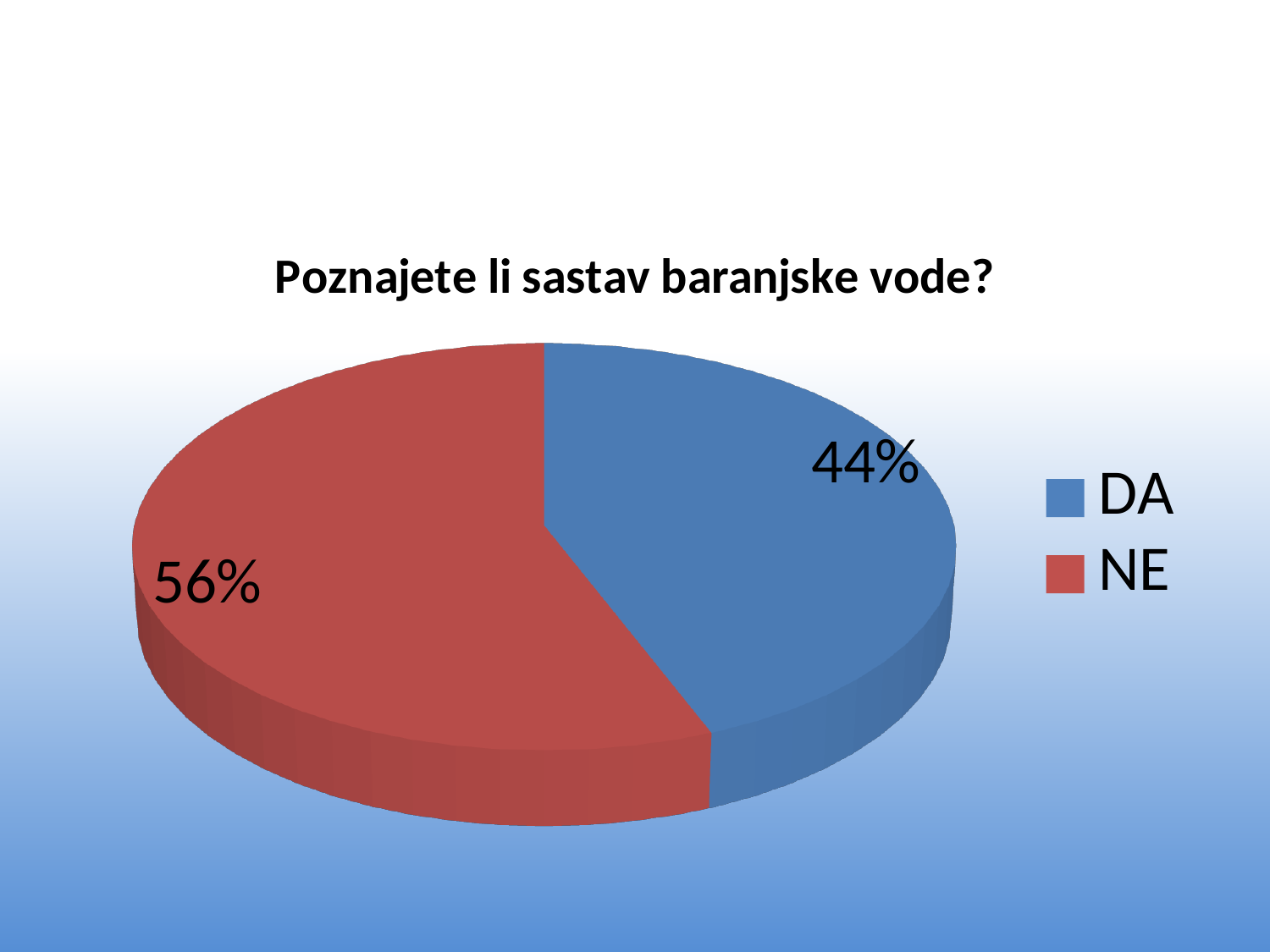
What is the title of the chart? Poznajete li sastav baranjske vode? How many categories are shown in the pie chart? 2 Which category has the largest slice of the pie? NE What share of the pie does NE represent? 56% Is the share for DA greater or less than 50%? less What share of the pie does DA represent? 44% Which category has the smallest slice of the pie? DA What is the difference in percentage points between the NE and DA slices? 12% What colour is the NE slice in the pie chart? Red What kind of chart is shown on the slide? Pie chart Which is larger, the DA slice or the NE slice? NE